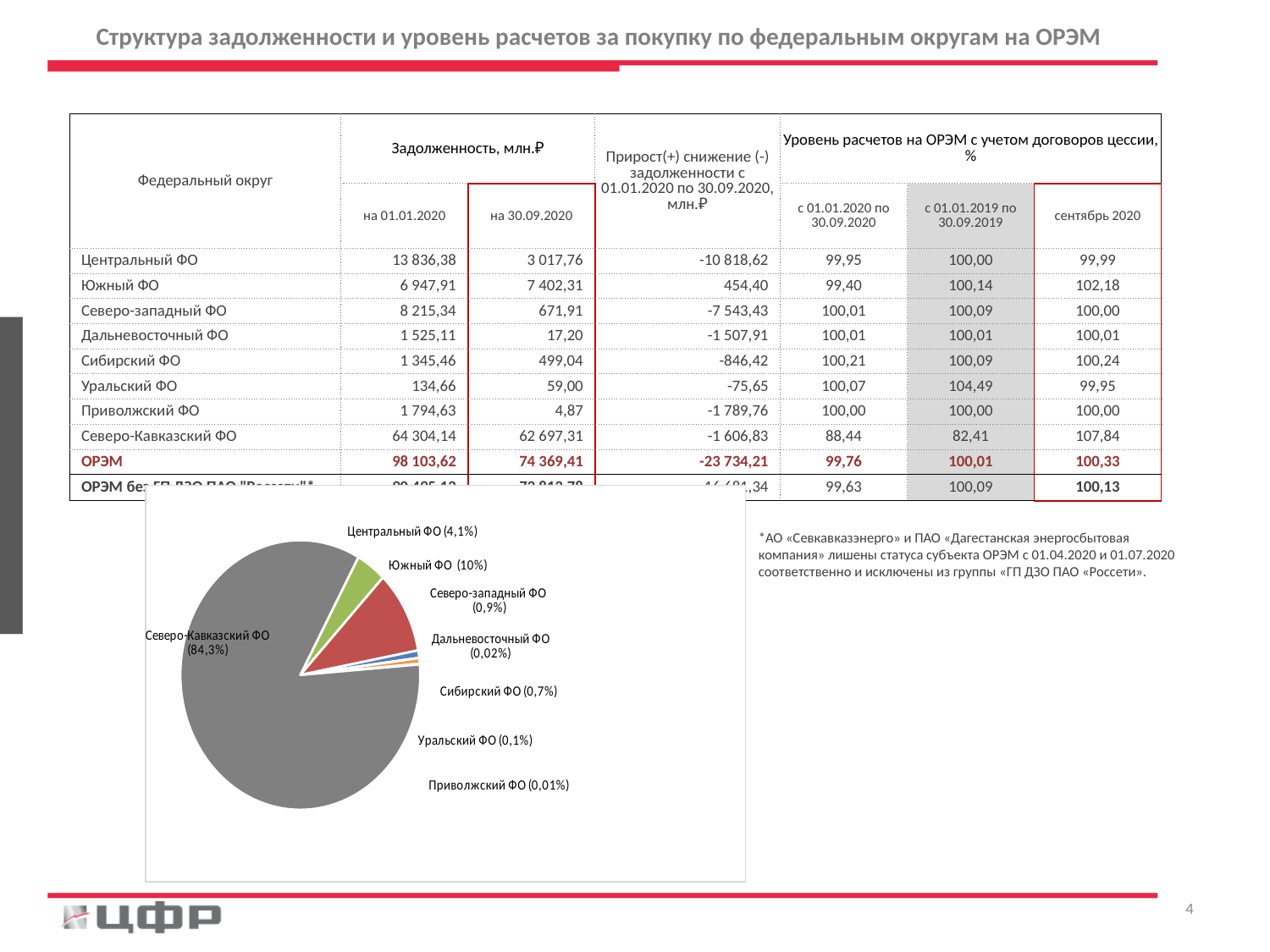
Which federal district has the smallest slice in the pie chart? Приволжский ФО What share of the pie does Южный ФО hold? 10% What share of the pie does Дальневосточный ФО hold? 0,02% What share of the pie does Центральный ФО hold? 4,1% What kind of chart is shown on the slide? Pie chart Which slice is larger in the pie chart, Южный ФО or Центральный ФО? Южный ФО How many slices does the pie chart have? 8 Which federal district has the largest slice in the pie chart? Северо-Кавказский ФО What is the difference in share between Южный ФО and Центральный ФО in the pie chart? 5,9%